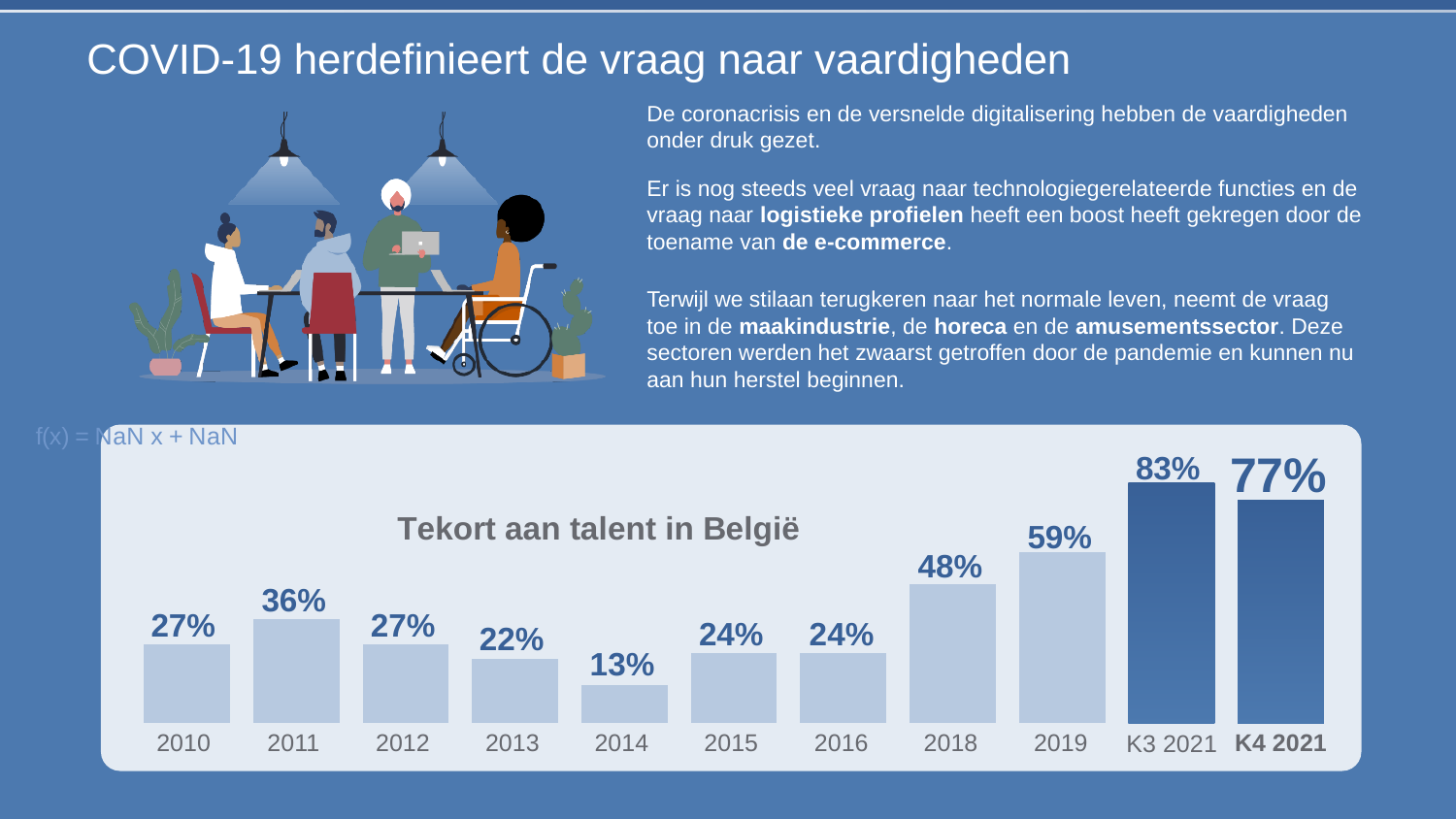
Do the values in the 'Tekort aan talent in België' chart generally rise or fall from 2014 to K3 2021? Rise What is the difference between the values for 2019 and 2018 in the 'Tekort aan talent in België' chart? 11% What kind of chart is 'Tekort aan talent in België'? Bar chart What is the title of the chart on the slide? Tekort aan talent in België What is the difference between the values for K3 2021 and K4 2021 in the 'Tekort aan talent in België' chart? 6% Which category has the highest value in the 'Tekort aan talent in België' chart? K3 2021 Which is larger in the 'Tekort aan talent in België' chart, the value for 2011 or the value for 2013? 2011 How many categories are shown on the x axis of the 'Tekort aan talent in België' chart? 11 What is the value for 2019 in the 'Tekort aan talent in België' chart? 59% What is the value for K3 2021 in the 'Tekort aan talent in België' chart? 83% What is the value for 2014 in the 'Tekort aan talent in België' chart? 13% Which category has the lowest value in the 'Tekort aan talent in België' chart? 2014